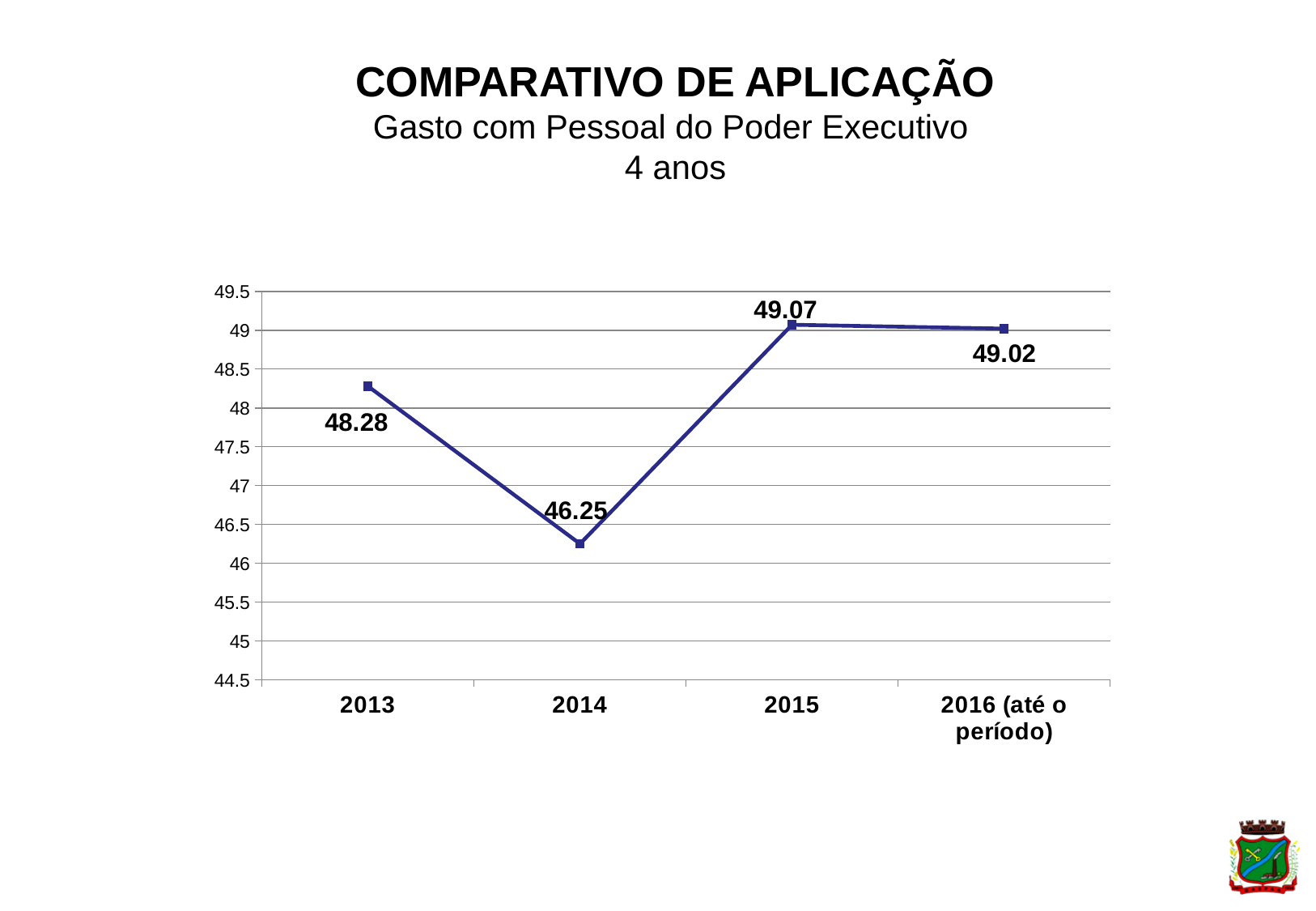
Which year has the lowest value? 2014 What is the value for 2013? 48.28 What is the value for 2014? 46.25 What is the value for 2016 (até o período)? 49.02 Which is larger, the value for 2013 or the value for 2014? 2013 How many data points are plotted on the chart? 4 Does the value rise or fall from 2014 to 2015? rise What kind of chart is shown on the slide? line chart What is the value for 2015? 49.07 What is the difference between the values for 2015 and 2016 (até o período)? 0.05 Which year has the highest value? 2015 What is the difference between the values for 2013 and 2014? 2.03